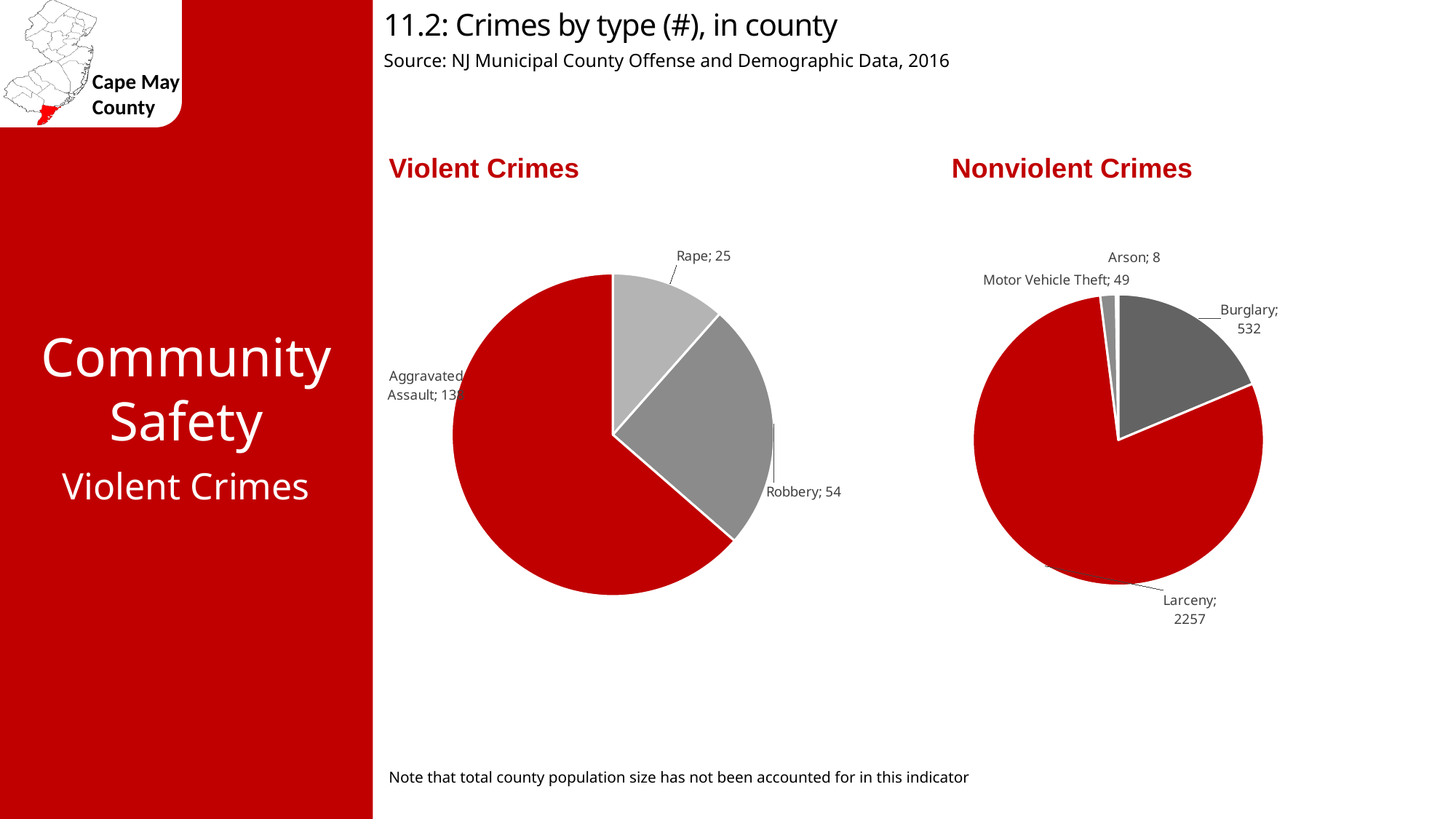
What type of chart is used for Violent Crimes? Pie chart In the Nonviolent Crimes chart, how many categories are shown? 4 In the Violent Crimes chart, how many rapes are shown? 25 In the Nonviolent Crimes chart, which category has the largest value? Larceny In the Nonviolent Crimes chart, what is the value for Burglary? 532 In the Nonviolent Crimes chart, which category has the smallest value? Arson In the Violent Crimes chart, which category has the largest slice? Aggravated Assault In the Nonviolent Crimes chart, what is the value for Motor Vehicle Theft? 49 In the Nonviolent Crimes chart, what is the difference between Burglary and Motor Vehicle Theft? 483 In the Violent Crimes chart, what is the difference between Robbery and Rape? 29 In the Violent Crimes chart, what is the value for Robbery? 54 In the Nonviolent Crimes chart, what is the value for Larceny? 2257